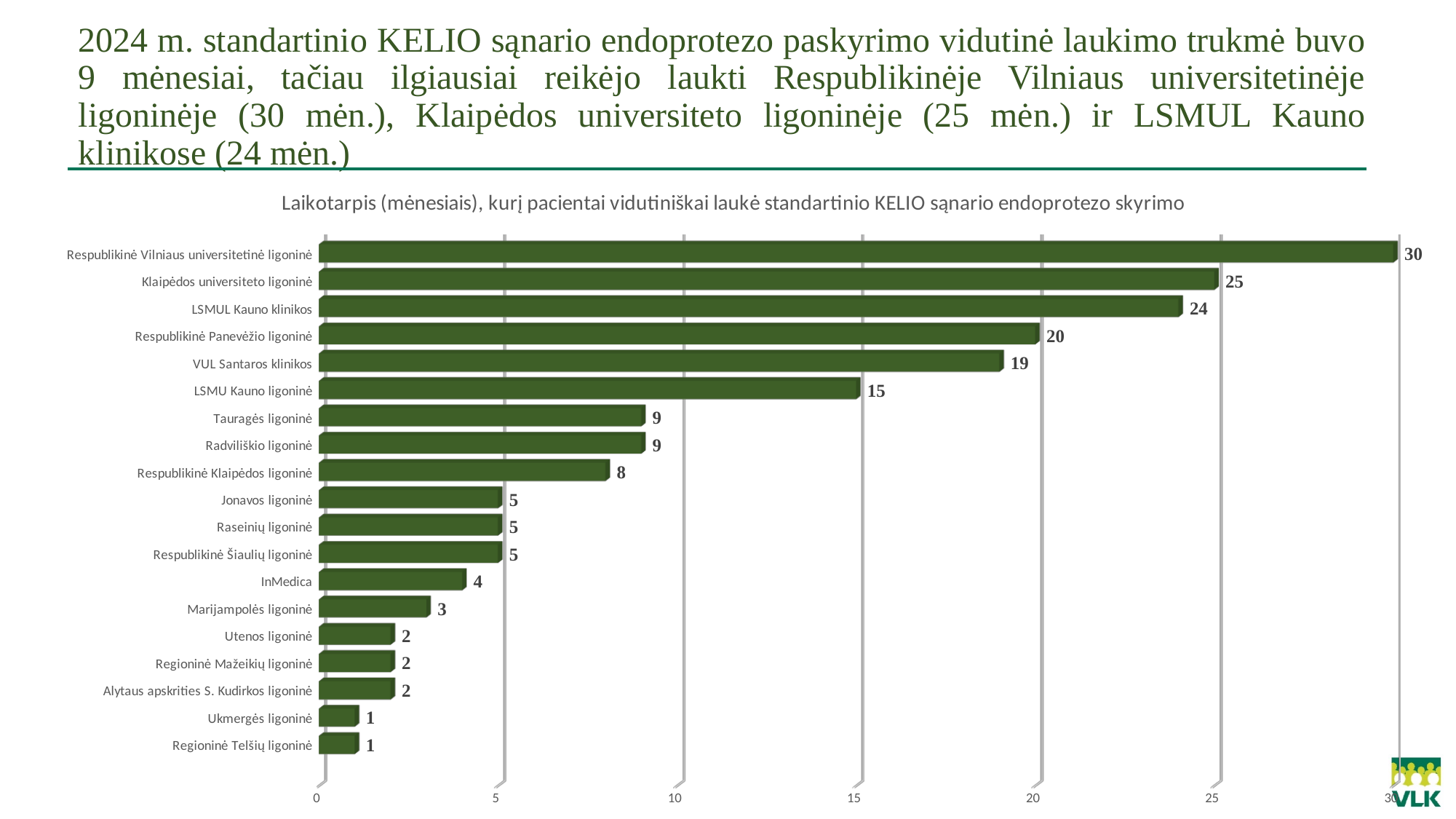
Is the value for LSMU Kauno ligoninė greater or less than 10? greater Which is larger, the value for LSMUL Kauno klinikos or the value for Respublikinė Panevėžio ligoninė? LSMUL Kauno klinikos What kind of chart is shown on the slide? bar chart Which hospital has the highest value? Respublikinė Vilniaus universitetinė ligoninė What is the value for VUL Santaros klinikos? 19 What is the title of the chart? Laikotarpis (mėnesiais), kurį pacientai vidutiniškai laukė standartinio KELIO sąnario endoprotezo skyrimo What is the value for Respublikinė Klaipėdos ligoninė? 8 What is the difference between the values for Klaipėdos universiteto ligoninė and LSMU Kauno ligoninė? 10 What is the value for Respublikinė Vilniaus universitetinė ligoninė? 30 What is the difference between the values for Respublikinė Panevėžio ligoninė and Marijampolės ligoninė? 17 What is the value for InMedica? 4 How many hospitals are shown in the chart? 19